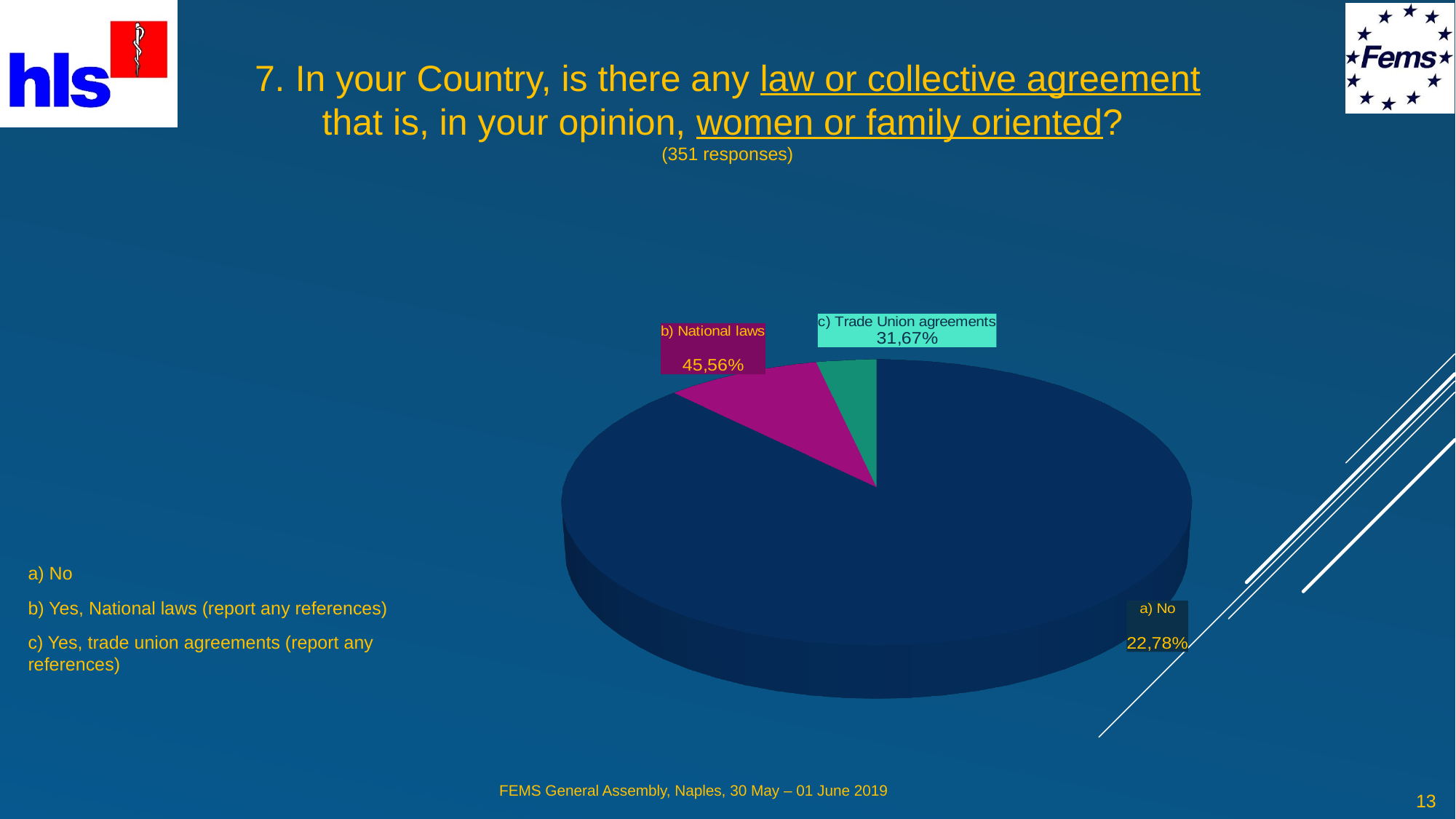
What is the difference between the percentages labelled for b) National laws and c) Trade Union agreements? 13,89% According to the data labels, which category has the highest percentage? b) National laws Which has the larger labelled percentage, b) National laws or a) No? b) National laws What percentage is shown for b) National laws? 45,56% According to the data labels, which category has the lowest percentage? a) No What is the difference between the percentages labelled for c) Trade Union agreements and a) No? 8,89% What percentage is shown for a) No? 22,78% What colour is the slice labelled b) National laws? Magenta What percentage is shown for c) Trade Union agreements? 31,67% How many responses does the slide say the chart is based on? 351 responses How many categories are shown in the pie chart? 3 What kind of chart is shown on the slide? Pie chart